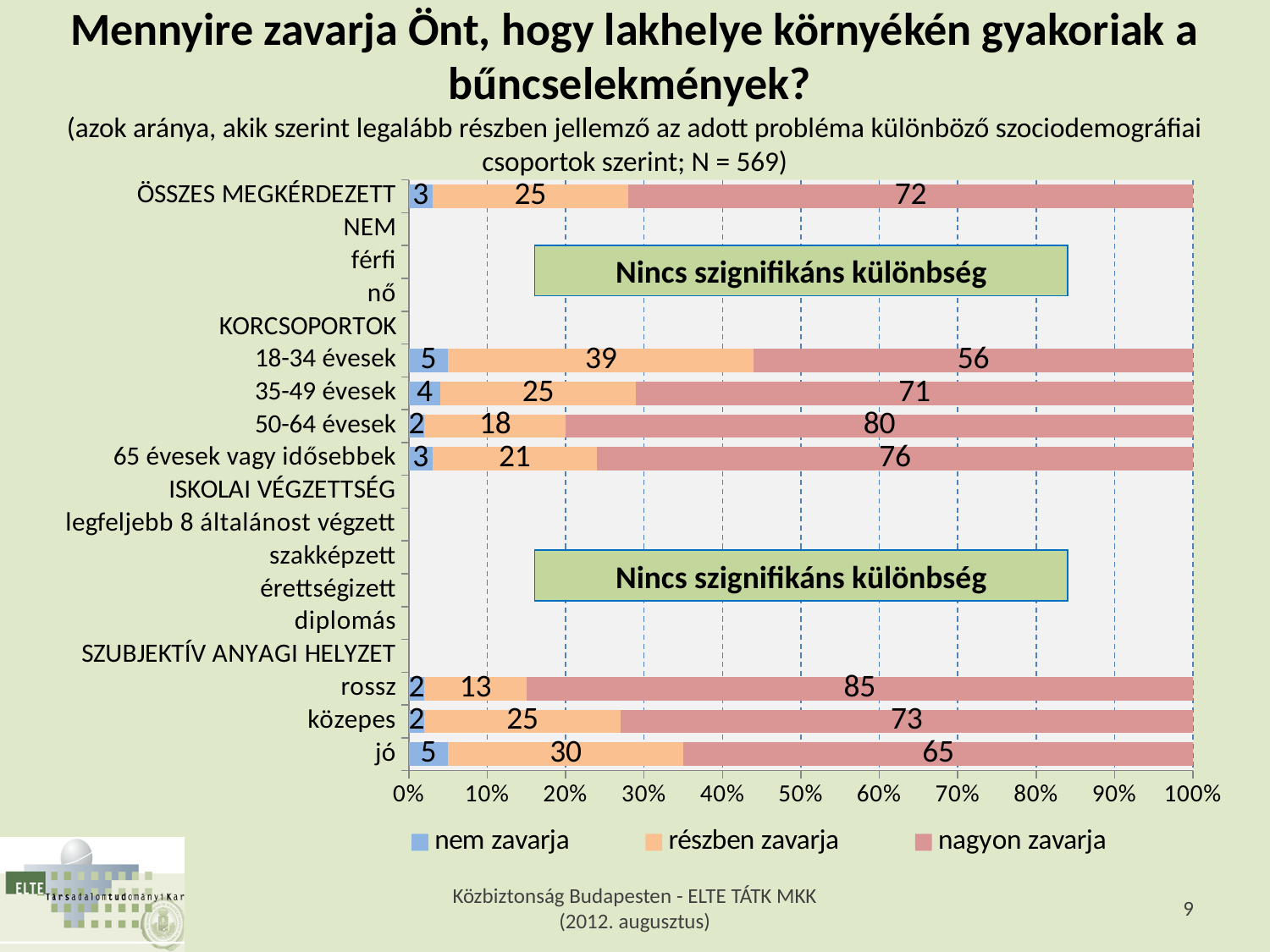
What is the total of the three segments for the 35-49 évesek bar? 100 What is the value of "nagyon zavarja" for ÖSSZES MEGKÉRDEZETT? 72 What is the value of "részben zavarja" for 18-34 évesek? 39 What kind of chart is shown on the slide? stacked bar chart How many series does the legend list? 3 What is the value of "nagyon zavarja" for rossz? 85 What text appears in the green boxes placed over the NEM and ISKOLAI VÉGZETTSÉG sections? Nincs szignifikáns különbség Among the age groups (KORCSOPORTOK), which has the highest "nagyon zavarja" value? 50-64 évesek Among the subjective financial situation groups (rossz, közepes, jó), which has the lowest "nagyon zavarja" value? jó Which is larger, the "részben zavarja" value for 18-34 évesek or for 65 évesek vagy idősebbek? 18-34 évesek What is the difference between the "nagyon zavarja" values for rossz and jó? 20 What is the value of "nem zavarja" for 50-64 évesek? 2